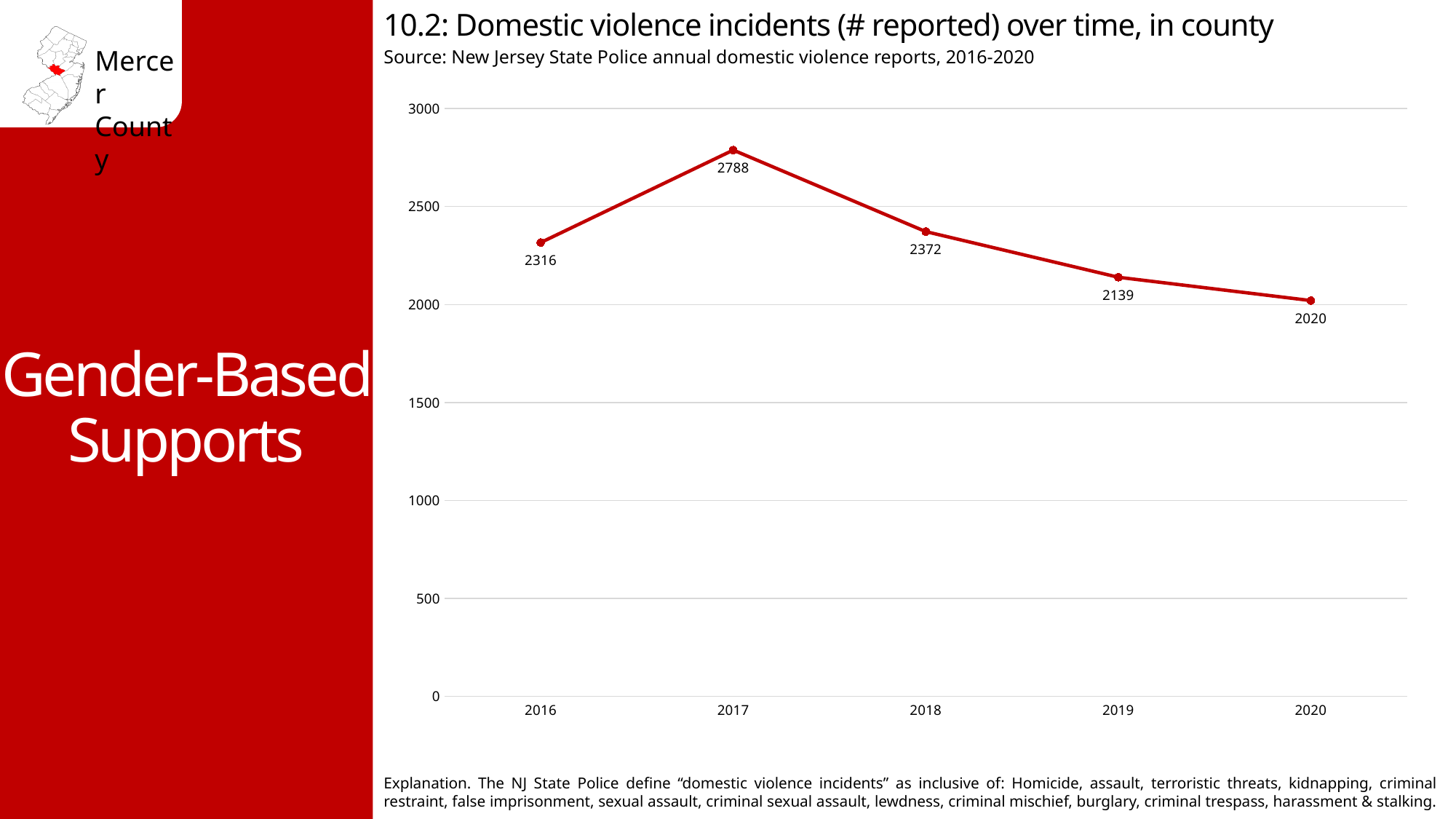
Which year had the lowest number of reported domestic violence incidents? 2020 What type of chart is shown on the slide? Line chart What is the difference between the 2017 and 2018 values? 416 How many domestic violence incidents were reported in 2017? 2788 From 2017 to 2020, do the values rise or fall? Fall What is the source cited for the chart data? New Jersey State Police annual domestic violence reports, 2016-2020 How many domestic violence incidents were reported in 2016? 2316 What is the value plotted for 2020? 2020 What is the value plotted for 2019? 2139 Which year had more reported incidents, 2016 or 2018? 2018 How many years (data points) are plotted on the chart? 5 Which year had the highest number of reported domestic violence incidents? 2017